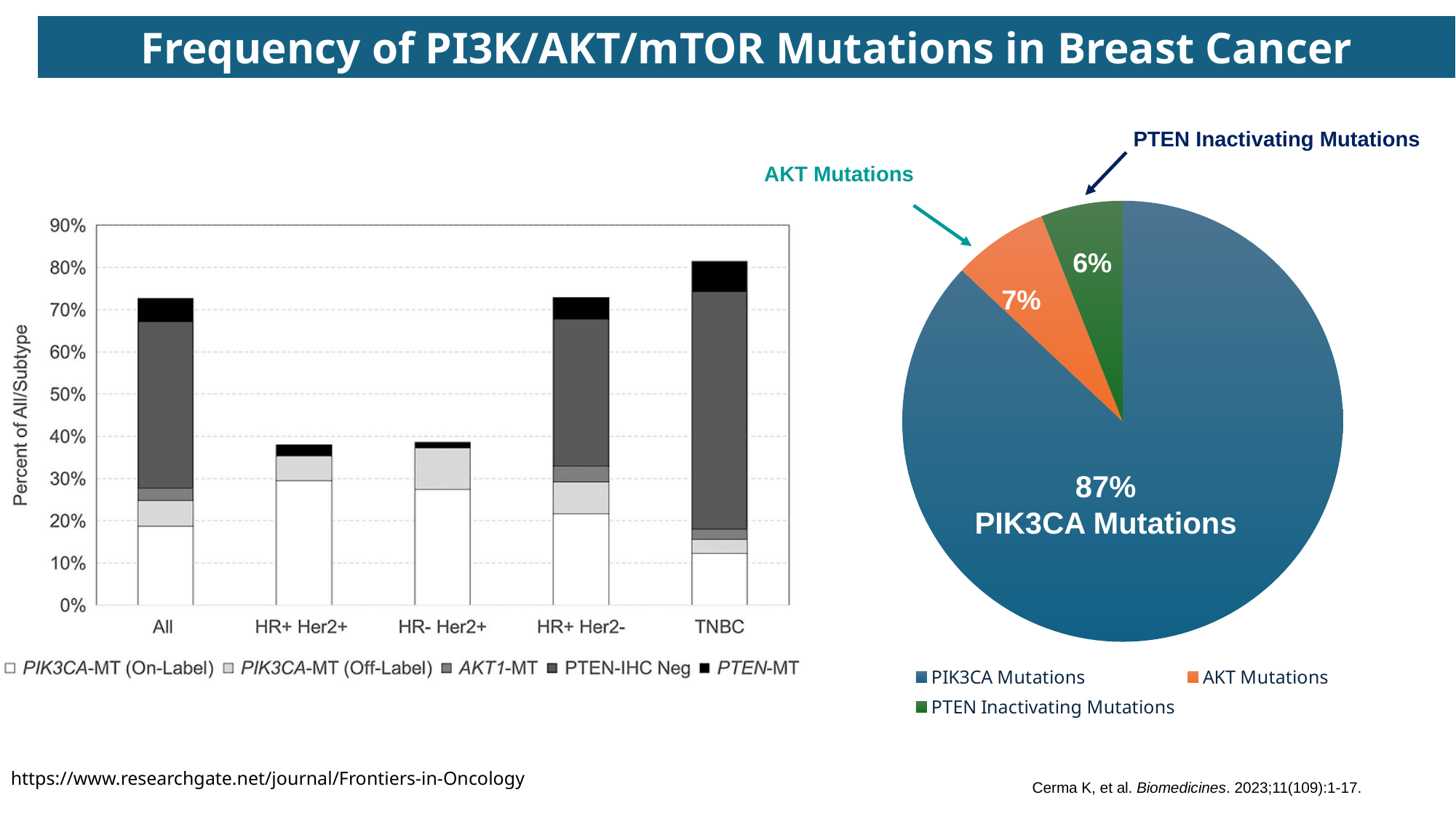
How many series does the legend of the bar chart on the left list? 5 In the pie chart on the right, what is the difference in percentage points between the PIK3CA Mutations slice and the AKT Mutations slice? 80 percentage points In the pie chart on the right, which slice is the largest? PIK3CA Mutations In the pie chart on the right, what share is labelled for AKT Mutations? 7% How many slices does the pie chart on the right have? 3 In the bar chart on the left, which category has the tallest stacked bar? TNBC What kind of chart is the chart on the left side of the slide? Stacked bar chart In the pie chart on the right, what share is labelled for PTEN Inactivating Mutations? 6% In the pie chart on the right, what share is labelled for PIK3CA Mutations? 87% How many categories are shown on the x axis of the bar chart on the left? 5 In the pie chart on the right, which slice is the smallest? PTEN Inactivating Mutations In the bar chart on the left, is the total stacked value for HR+ Her2+ greater or less than 50%? less